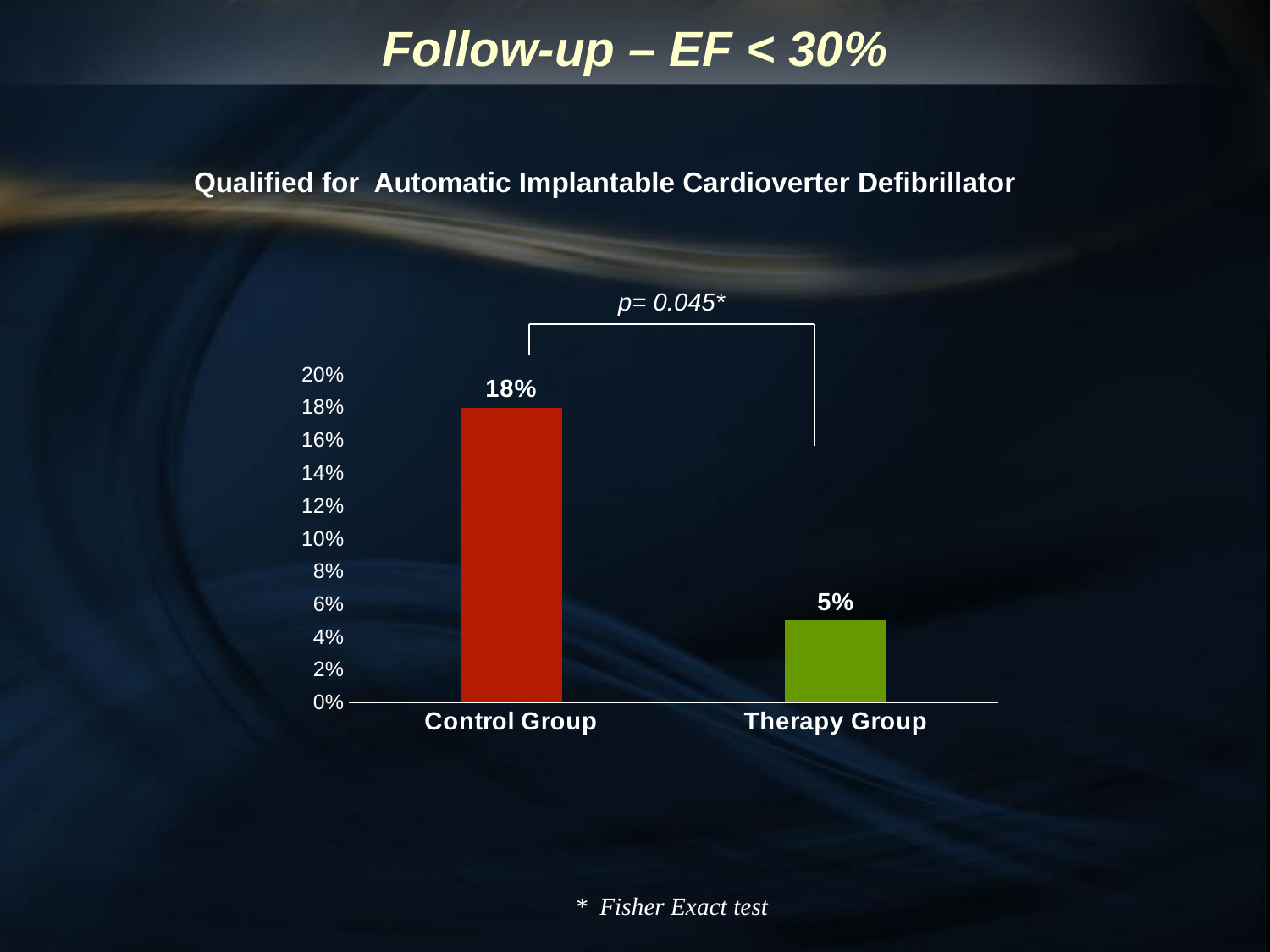
What is the value for the Control Group? 18% Is the value for the Control Group greater or less than 10%? greater What kind of chart is shown on the slide? Bar chart What p-value is shown above the bars? p= 0.045* What is the difference between the Control Group and Therapy Group values? 13% Which group has the lowest value? Therapy Group Which group has the highest value? Control Group Which is larger, the value for the Control Group or the Therapy Group? Control Group Is the value for the Therapy Group greater or less than 10%? less How many categories are shown on the chart? 2 What colour is the Therapy Group bar? Green What is the value for the Therapy Group? 5%